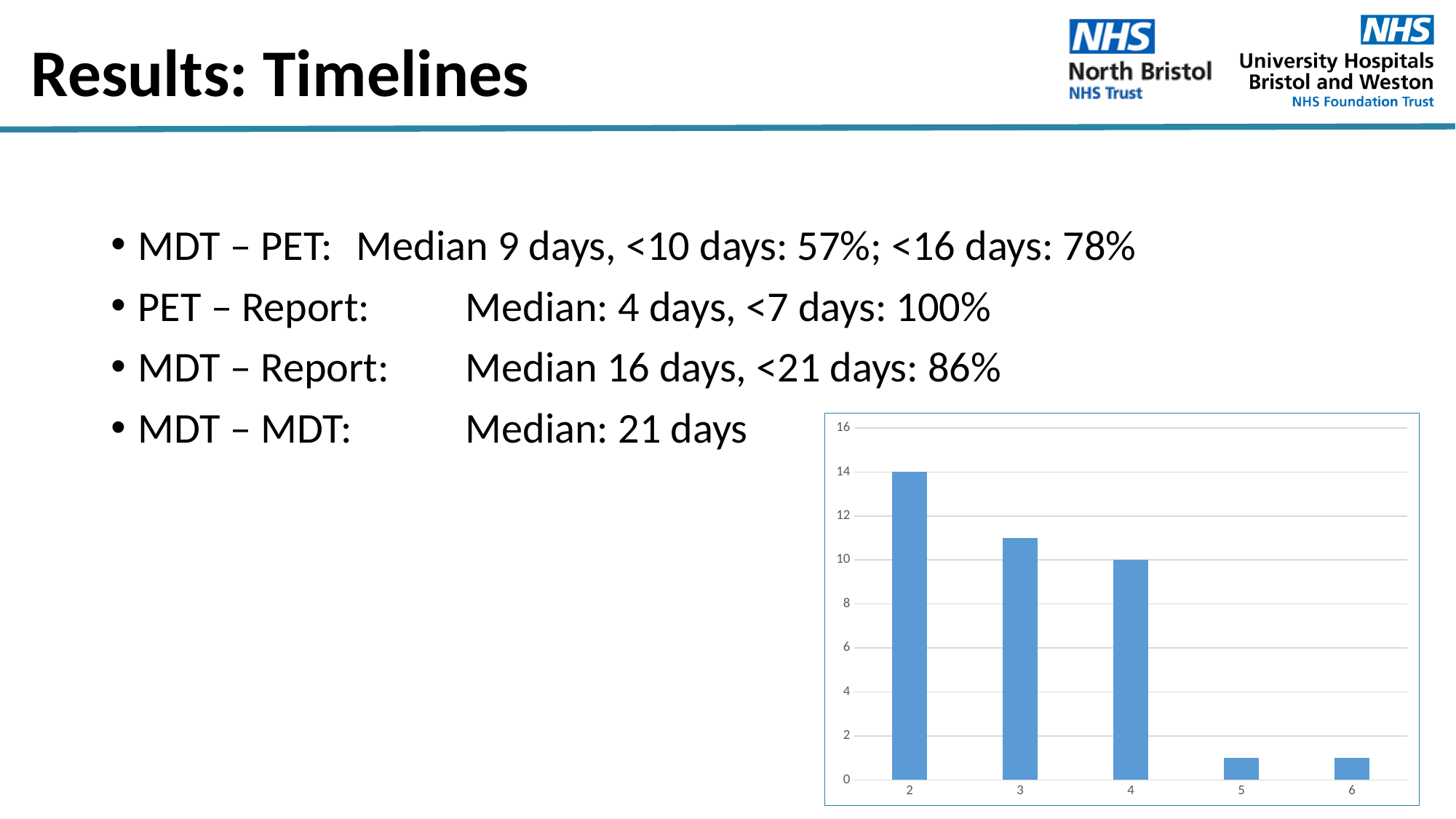
Which category has the highest bar? 2 How many categories are shown on the x axis of the chart? 5 Is the value for category 6 greater or less than 4? less Is the value for category 3 greater or less than 12? less What is the value of the bar for category 4? 10 Is the value for category 5 greater or less than 2? less What kind of chart is shown on the slide? bar chart Do the bar values rise or fall as you move from category 2 to category 6 along the x axis? fall Which is larger, the bar for category 4 or the bar for category 5? 4 What is the value of the bar for category 2? 14 Which is larger, the bar for category 2 or the bar for category 3? 2 What is the difference between the bar for category 2 and the bar for category 4? 4